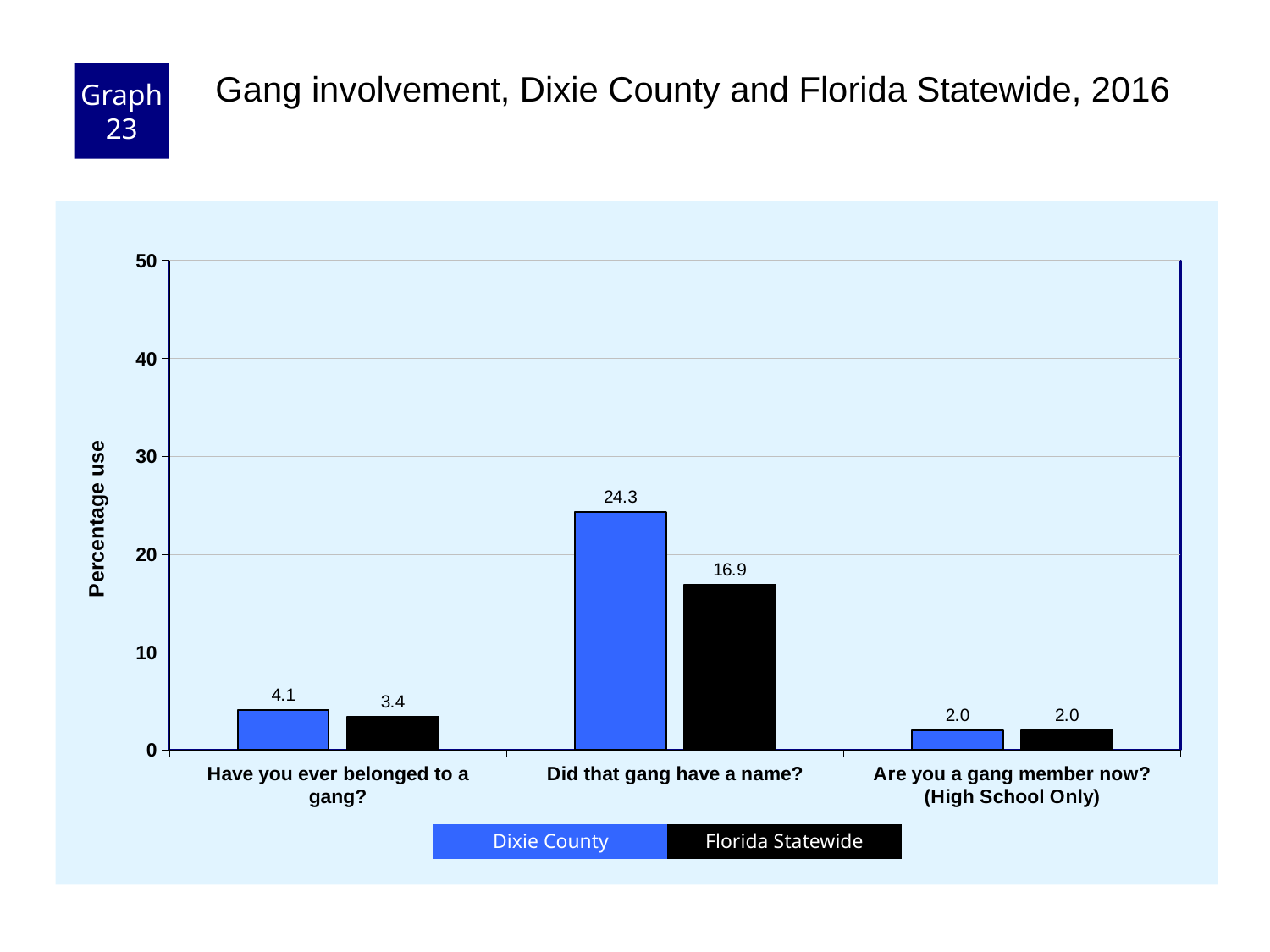
How many series does the legend list? 2 What kind of chart is shown on the slide? bar chart What is the Florida Statewide value for "Have you ever belonged to a gang?"? 3.4 Is the Florida Statewide value for "Did that gang have a name?" greater or less than 20? less How many question categories are shown on the x axis? 3 What is the Dixie County value for "Did that gang have a name?"? 24.3 What is the Dixie County value for "Are you a gang member now? (High School Only)"? 2.0 What is the label of the y axis? Percentage use Which question has the highest Dixie County value? Did that gang have a name? For "Have you ever belonged to a gang?", which is larger: Dixie County or Florida Statewide? Dixie County What is the difference between the Dixie County and Florida Statewide values for "Did that gang have a name?"? 7.4 Which question has the lowest Florida Statewide value? Are you a gang member now? (High School Only)